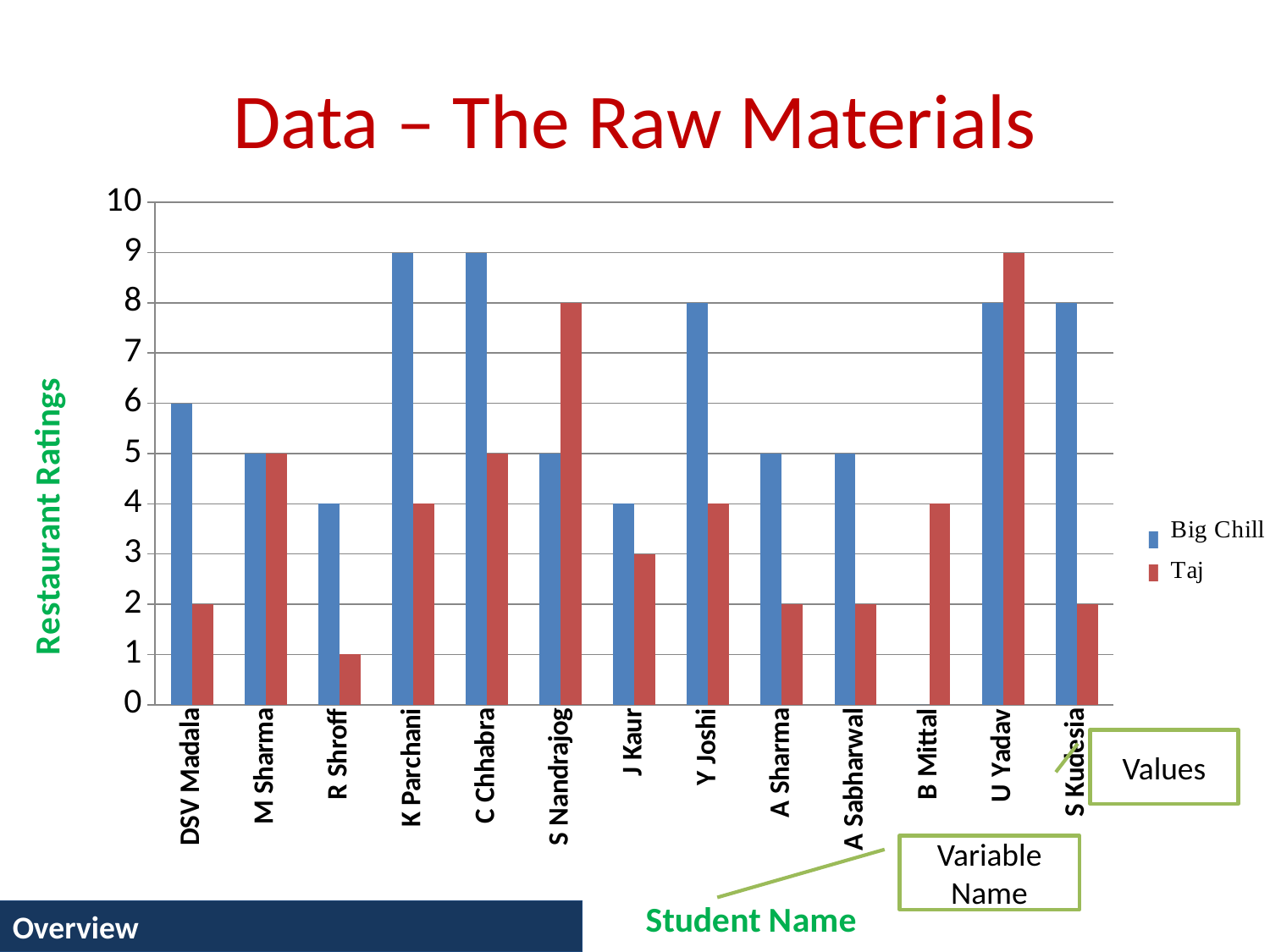
Is the Taj rating for J Kaur greater or less than 5? less What is the Big Chill rating for DSV Madala? 6 What is the Taj rating for S Nandrajog? 8 What is the difference between the Big Chill and Taj ratings for C Chhabra? 4 For Y Joshi, which is larger, the Big Chill rating or the Taj rating? Big Chill What is the title of the slide? Data – The Raw Materials How many series does the legend list? 2 What is the label of the y axis? Restaurant Ratings What type of chart is shown on the slide? bar chart Which student has the lowest Taj rating? R Shroff What is the Big Chill rating for K Parchani? 9 Which student has the highest Taj rating? U Yadav